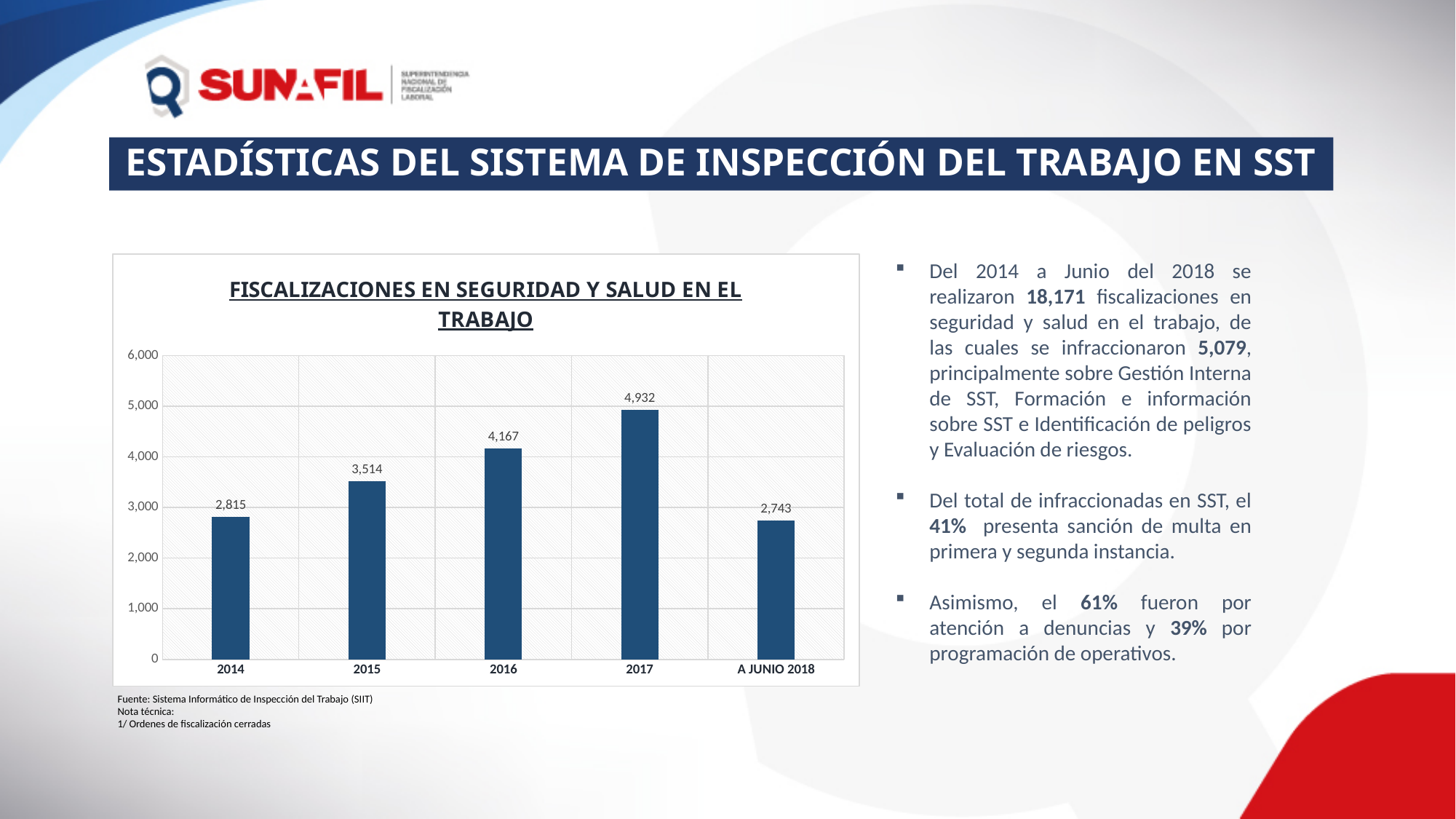
What is the value for A JUNIO 2018? 2,743 What is the difference between the values for 2015 and 2014? 699 Which category has the highest value? 2017 Is the value for 2016 greater or less than 4,000? greater What kind of chart is shown? bar chart How many categories are shown on the x axis? 5 What is the title of the chart? FISCALIZACIONES EN SEGURIDAD Y SALUD EN EL TRABAJO Which is larger, the value for 2016 or the value for 2015? 2016 Which category has the lowest value? A JUNIO 2018 What is the value for 2014? 2,815 What is the difference between the values for 2017 and 2016? 765 What is the value for 2017? 4,932